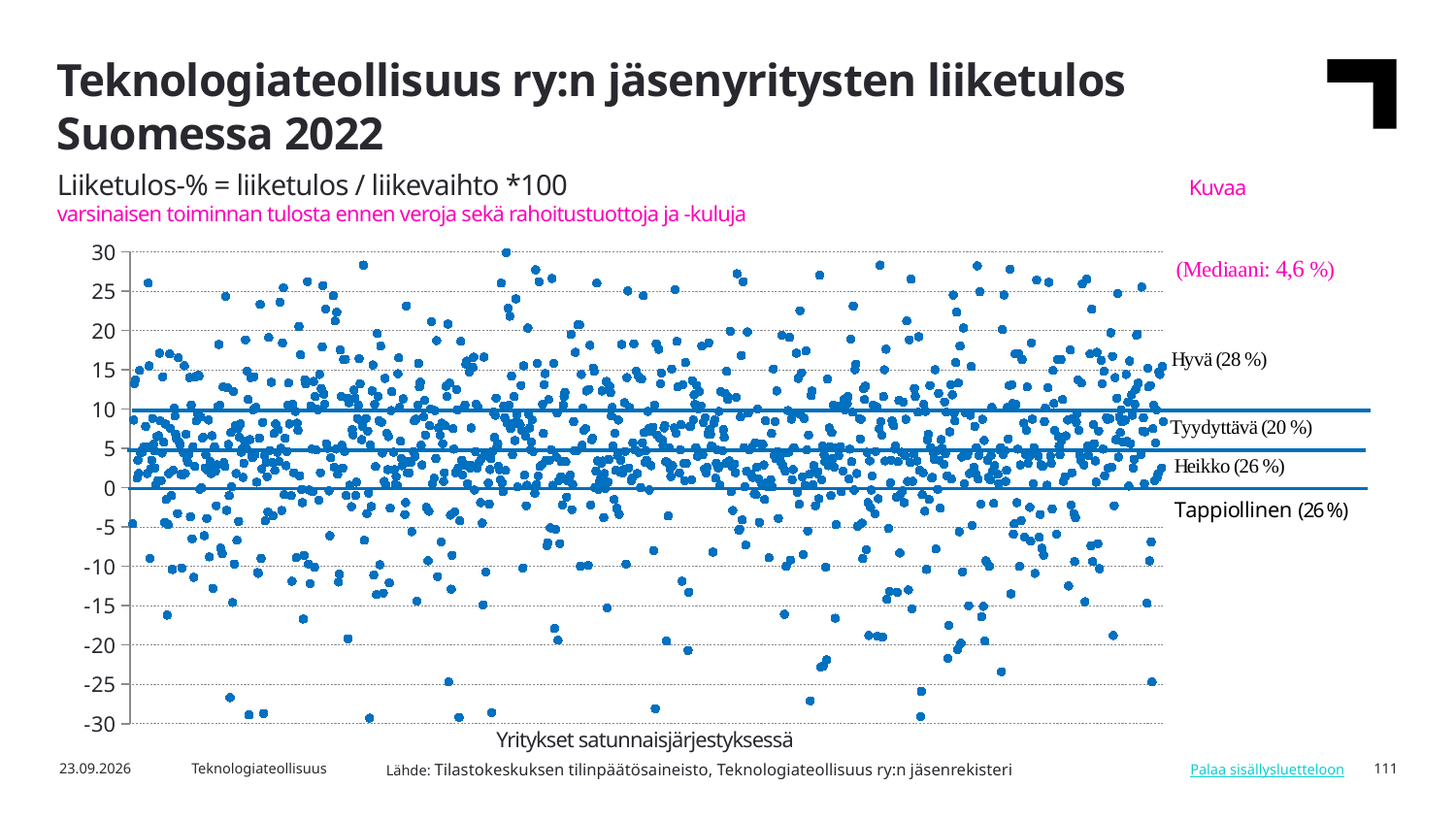
How many profitability groups are labelled on the chart? 4 What kind of chart is shown on the slide? Scatter chart Which group has a larger share of companies, Hyvä or Heikko? Hyvä What is the median operating profit percentage (Mediaani) shown on the chart? 4,6 % What share of companies falls into the Heikko group? 26 % Which of the four groups (Hyvä, Tyydyttävä, Heikko, Tappiollinen) has the smallest share of companies? Tyydyttävä What is the difference in percentage points between the Hyvä share and the Tyydyttävä share? 8 What share of companies falls into the Tappiollinen group? 26 % Which of the four groups (Hyvä, Tyydyttävä, Heikko, Tappiollinen) has the largest share of companies? Hyvä What share of companies falls into the Hyvä group? 28 % What share of companies falls into the Tyydyttävä group? 20 % What is the label of the x axis of the chart? Yritykset satunnaisjärjestyksessä